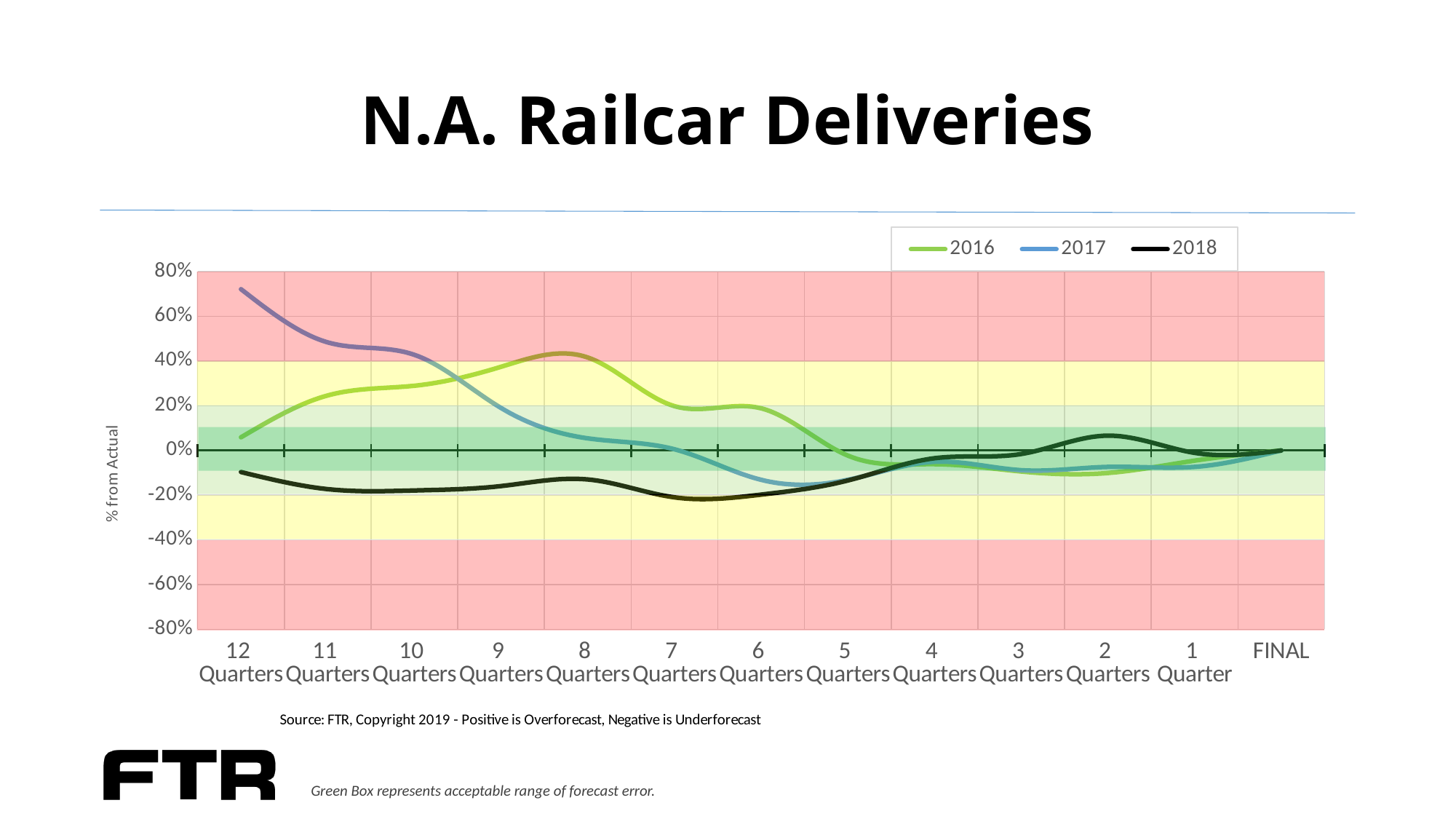
How many categories are shown along the x axis? 13 Which series has the highest value at 8 Quarters? 2016 Which series has the lowest value at 12 Quarters? 2018 At 8 Quarters, which is larger: the value for 2016 or the value for 2018? 2016 Which series has the highest value at 12 Quarters? 2017 Is the value for 2018 at 11 Quarters greater or less than 0%? less Is the value for 2017 at 12 Quarters greater or less than 60%? greater How many series does the legend list? 3 Is the value for 2016 at 10 Quarters greater or less than 20%? greater Does the 2017 series rise or fall from 12 Quarters to 5 Quarters? fall What kind of chart is shown on the slide? line chart What is the label on the y axis? % from Actual